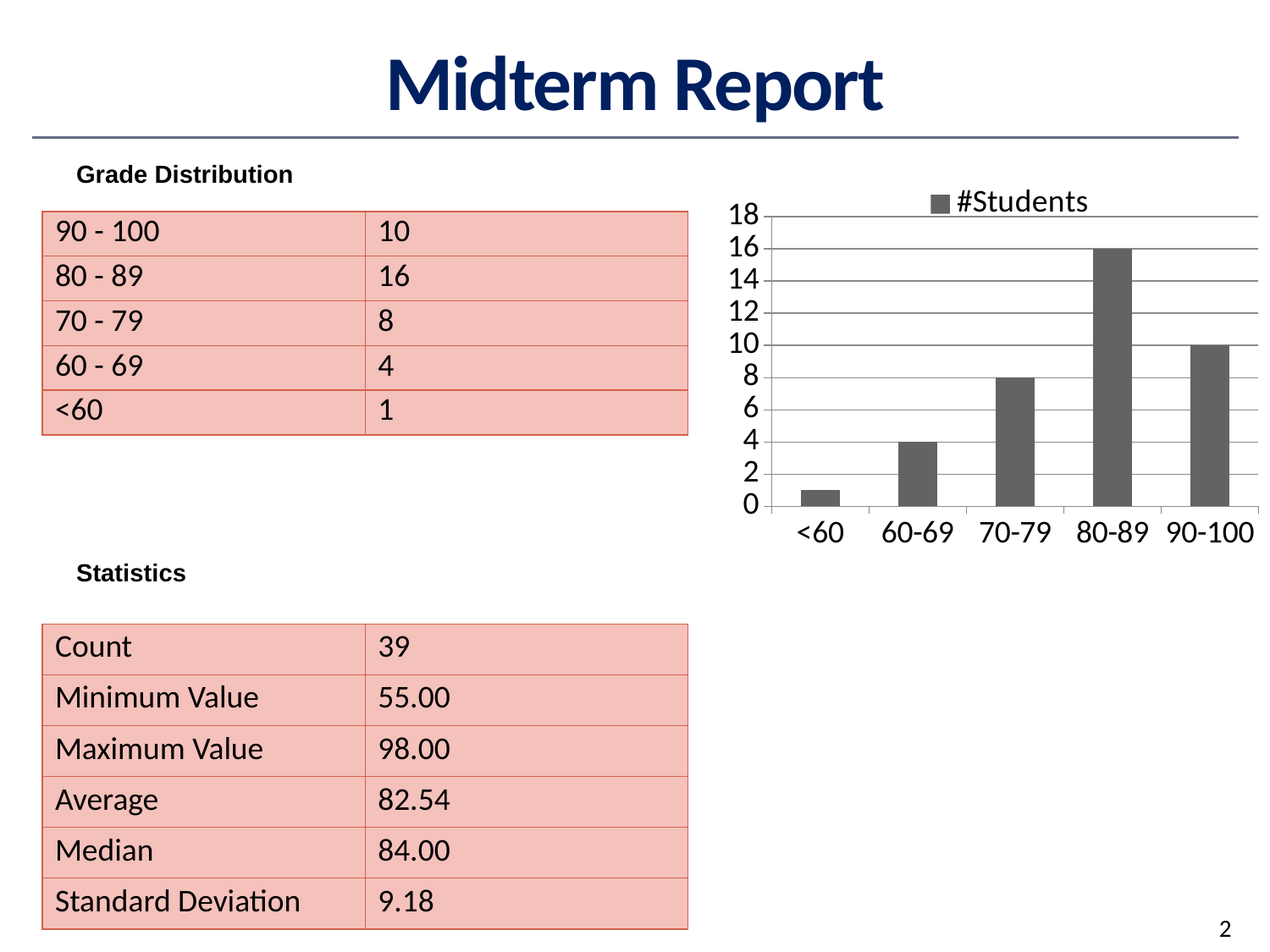
Which grade range has the highest number of students in the chart? 80-89 What is the difference in number of students between the 80-89 and 90-100 grade ranges? 6 How many grade ranges are shown on the x axis of the chart? 5 What type of chart is shown on the slide? bar chart How many students are in the 60-69 grade range according to the chart? 4 How many students are in the 80-89 grade range according to the chart? 16 How many students are in the 90-100 grade range according to the chart? 10 What series name is shown in the chart legend? #Students How many students are in the 70-79 grade range according to the chart? 8 Which grade range has more students, 60-69 or 70-79? 70-79 Is the value for the <60 grade range greater or less than 2? less Which grade range has the lowest number of students in the chart? <60